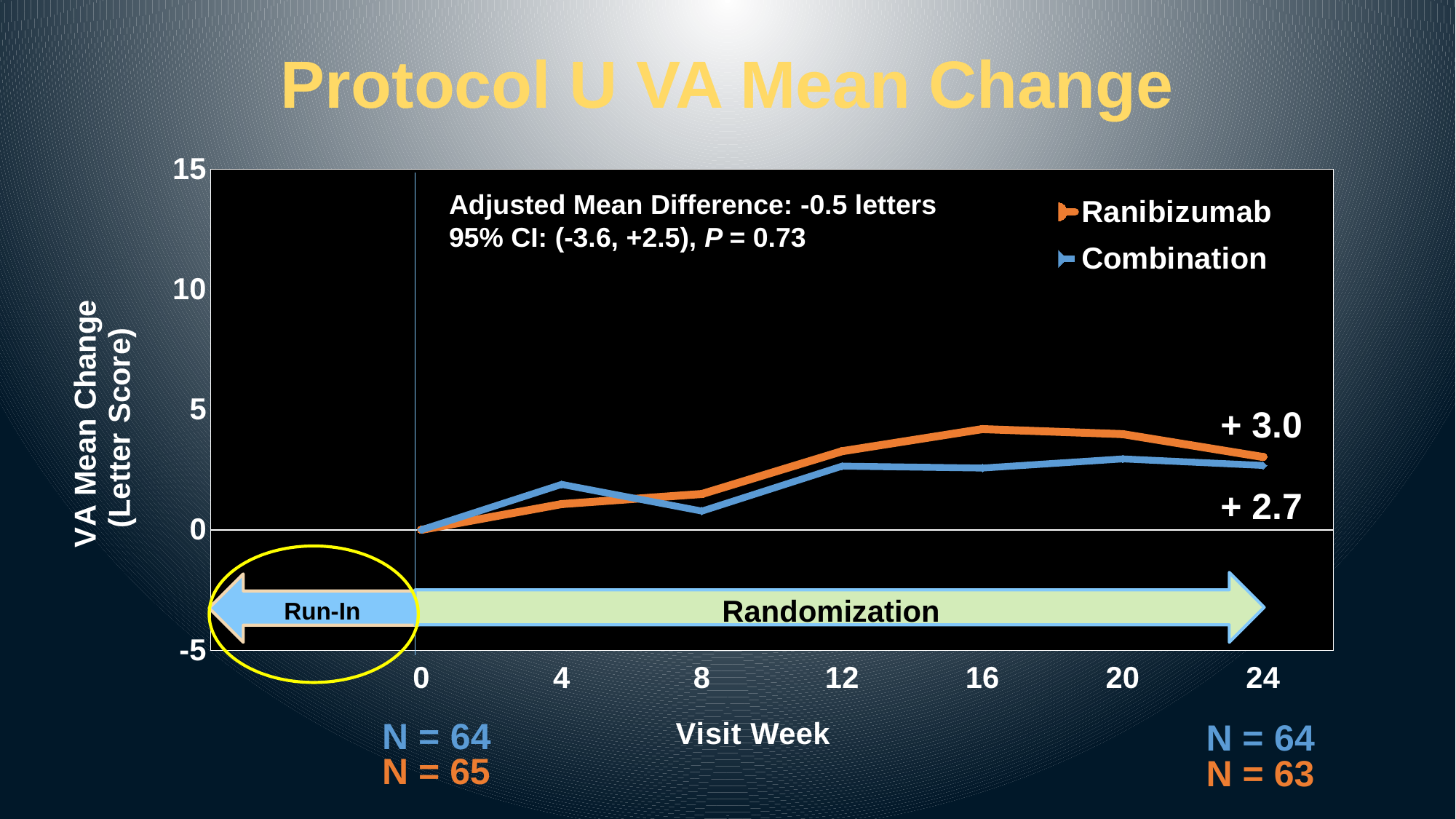
What are the two series named in the legend? Ranibizumab and Combination Is the value for Ranibizumab at visit week 16 greater or less than 5? less Overall, do the VA mean change values rise or fall from visit week 0 to visit week 24? Rise How many visit weeks are marked on the x axis? 7 What is the VA mean change for Combination at visit week 24? + 2.7 At visit week 16, which series has the higher value, Ranibizumab or Combination? Ranibizumab What is the difference between the Ranibizumab and Combination values at visit week 24? 0.3 How many series does the legend list? 2 Which series has the higher VA mean change at visit week 24? Ranibizumab What is the VA mean change for Ranibizumab at visit week 24? + 3.0 What is the title of the chart? Protocol U VA Mean Change What kind of chart is shown on the slide? Line chart